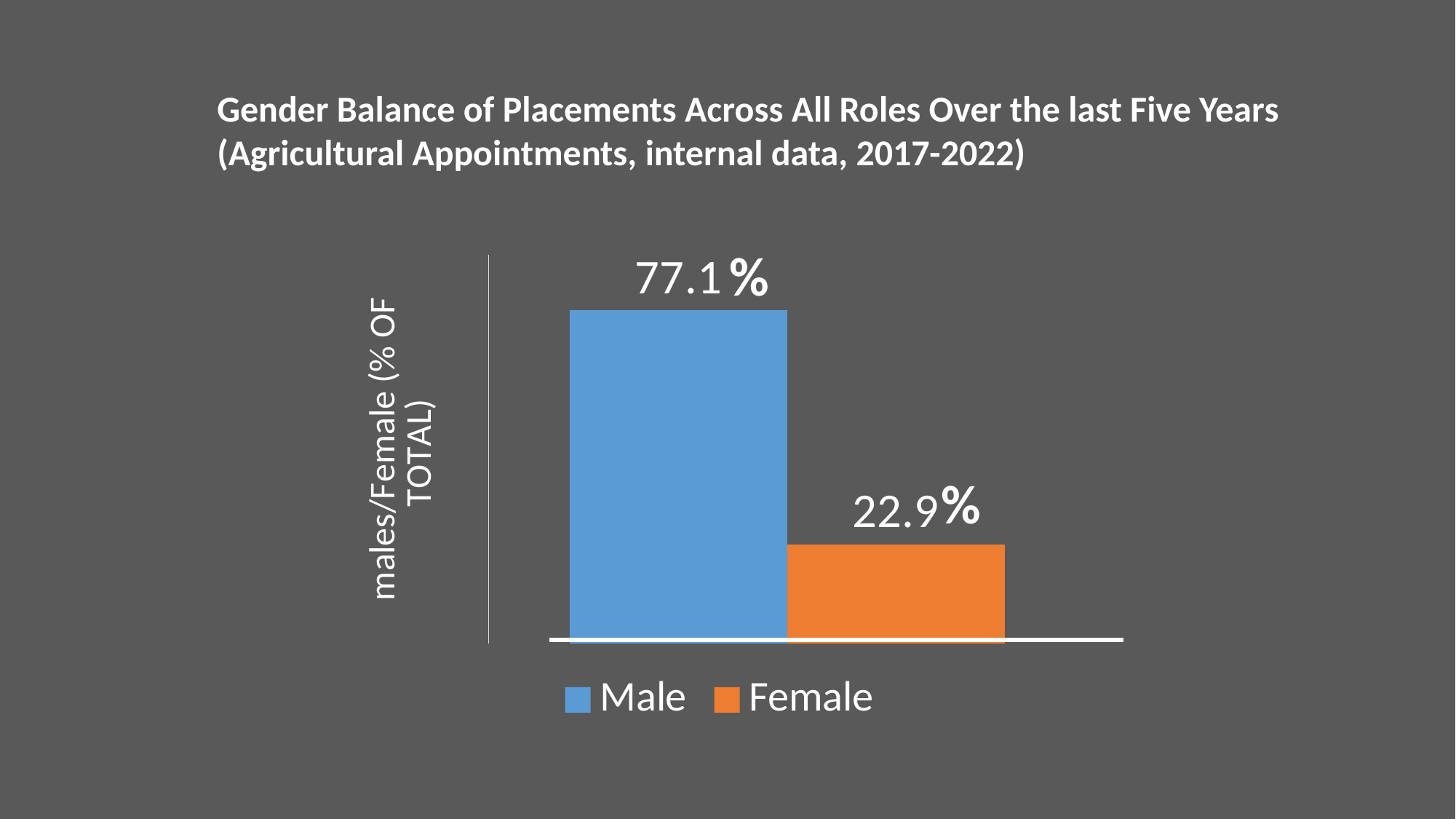
What is the difference between the Male and Female percentages? 54.2% What percentage of placements were female? 22.9% How many series does the legend list? 2 Which series has the higher value, Male or Female? Male Which series has the lower value? Female What is the total of the Male and Female percentages? 100% What kind of chart is shown on the slide? bar chart What percentage of placements were male? 77.1% Is the Female value larger or smaller than the Male value? smaller What time period does the chart title say the data covers? 2017-2022 What colour is the Male bar? blue